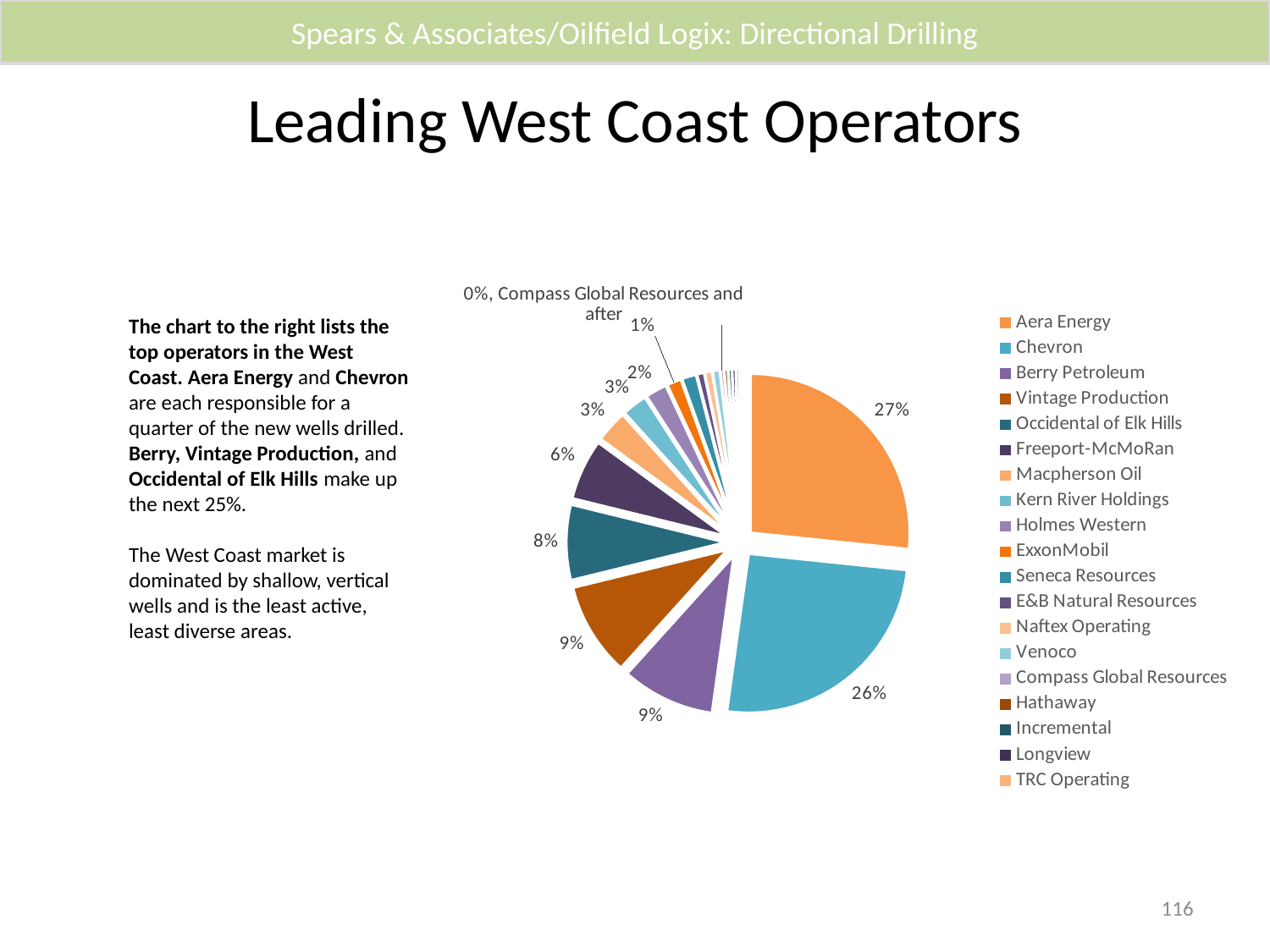
By how many percentage points does Aera Energy's share exceed Chevron's? 1 percentage point What percentage is shown for Freeport-McMoRan? 6% Which has the larger share, Vintage Production or Freeport-McMoRan? Vintage Production What is the combined share of Aera Energy and Chevron? 53% Which operator has the largest share of the pie? Aera Energy What colour is the Aera Energy slice? Orange What kind of chart is shown on the slide? Pie chart What share of the pie does Aera Energy hold? 27% What percentage is shown for Occidental of Elk Hills? 8% How many operators are listed in the chart's legend? 19 What percentage is shown for Chevron? 26% What percentage is shown for Berry Petroleum? 9%